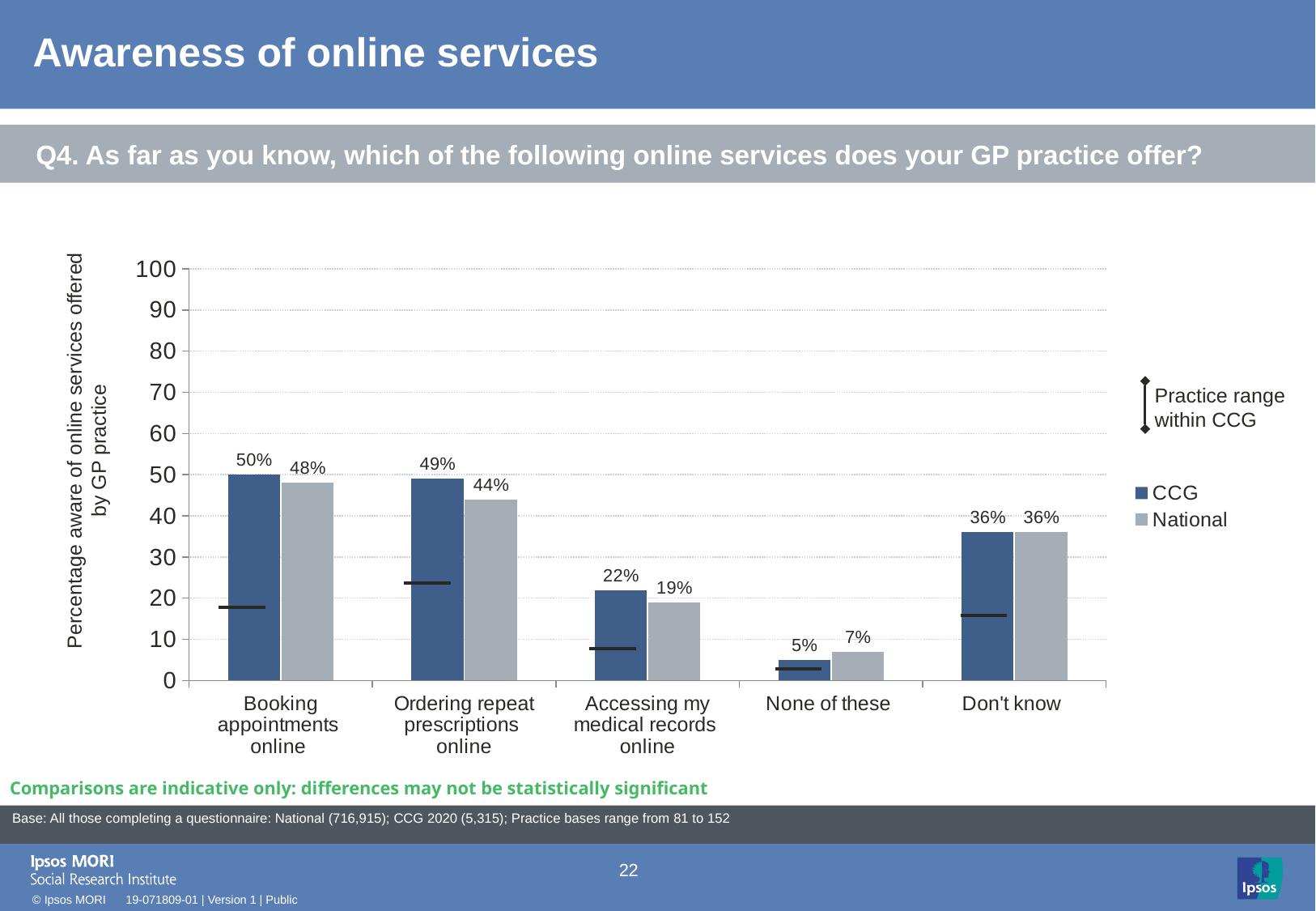
Which is larger for Accessing my medical records online, the CCG value or the National value? CCG Which category has the lowest CCG value? None of these What is the National value for Ordering repeat prescriptions online? 44% What is the CCG value for Accessing my medical records online? 22% Which category has the highest National value? Booking appointments online What is the CCG value for Booking appointments online? 50% What kind of chart is shown on the slide? Bar chart How many series does the legend list as bars? 2 What is the National value for None of these? 7% What is the difference between the CCG and National values for Ordering repeat prescriptions online? 5% What does the vertical line marker in the legend represent? Practice range within CCG How many categories are shown on the x axis? 5